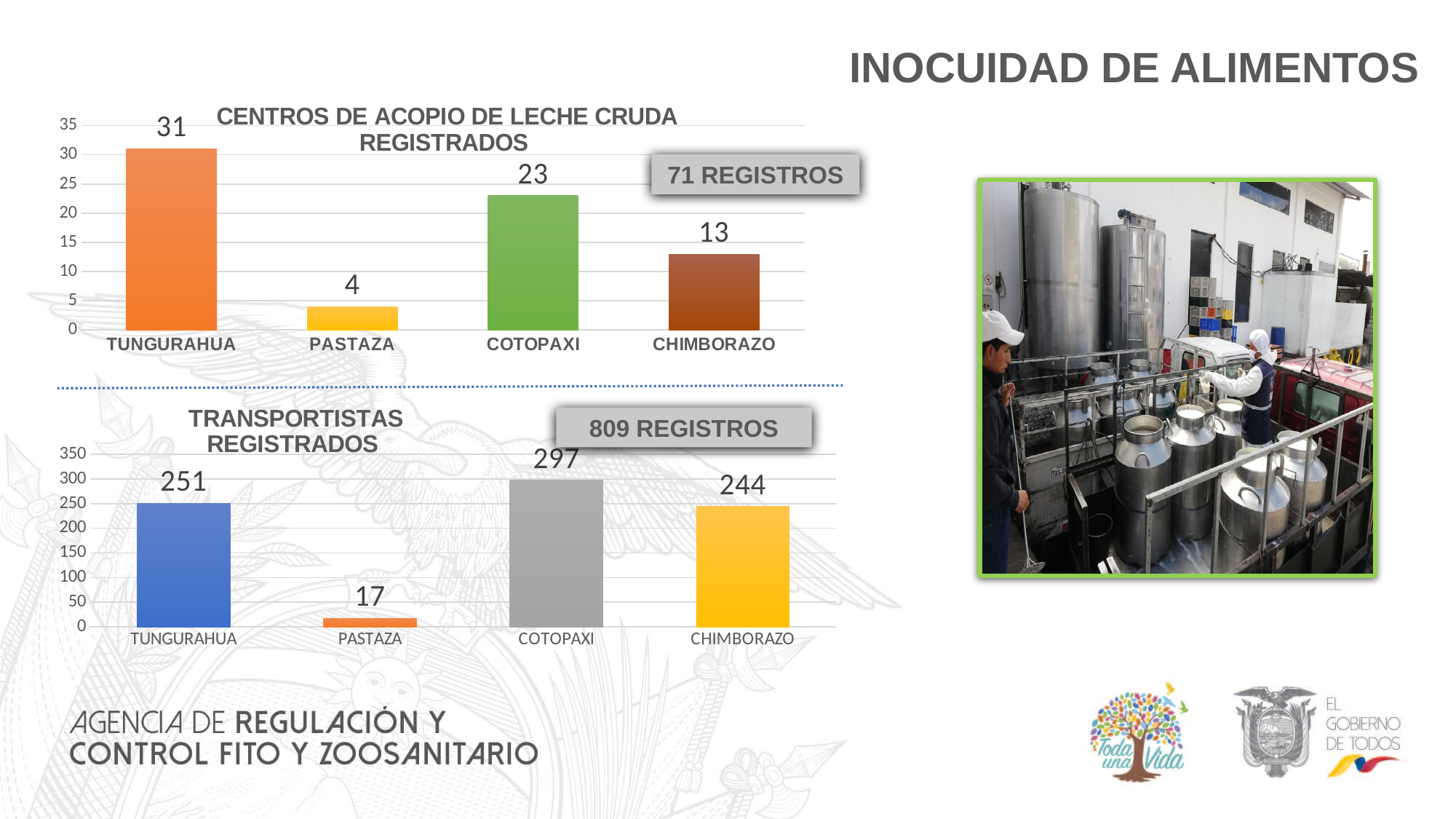
In the 'TRANSPORTISTAS REGISTRADOS' chart, which province has the highest value? COTOPAXI In the 'TRANSPORTISTAS REGISTRADOS' chart, which is larger, TUNGURAHUA or CHIMBORAZO? TUNGURAHUA In the 'CENTROS DE ACOPIO DE LECHE CRUDA REGISTRADOS' chart, what total number of registros is stated in the box? 71 REGISTROS In the 'TRANSPORTISTAS REGISTRADOS' chart, is the value for CHIMBORAZO greater or less than 200? greater In the 'TRANSPORTISTAS REGISTRADOS' chart, what is the difference between COTOPAXI and TUNGURAHUA? 46 In the 'CENTROS DE ACOPIO DE LECHE CRUDA REGISTRADOS' chart, what is the value for TUNGURAHUA? 31 In the 'CENTROS DE ACOPIO DE LECHE CRUDA REGISTRADOS' chart, what is the difference between COTOPAXI and CHIMBORAZO? 10 In the 'TRANSPORTISTAS REGISTRADOS' chart, what is the value for COTOPAXI? 297 In the 'CENTROS DE ACOPIO DE LECHE CRUDA REGISTRADOS' chart, which province has the lowest value? PASTAZA What type of chart is the 'TRANSPORTISTAS REGISTRADOS' chart? Bar chart In the 'CENTROS DE ACOPIO DE LECHE CRUDA REGISTRADOS' chart, how many provinces are shown? 4 In the 'TRANSPORTISTAS REGISTRADOS' chart, what is the value for PASTAZA? 17